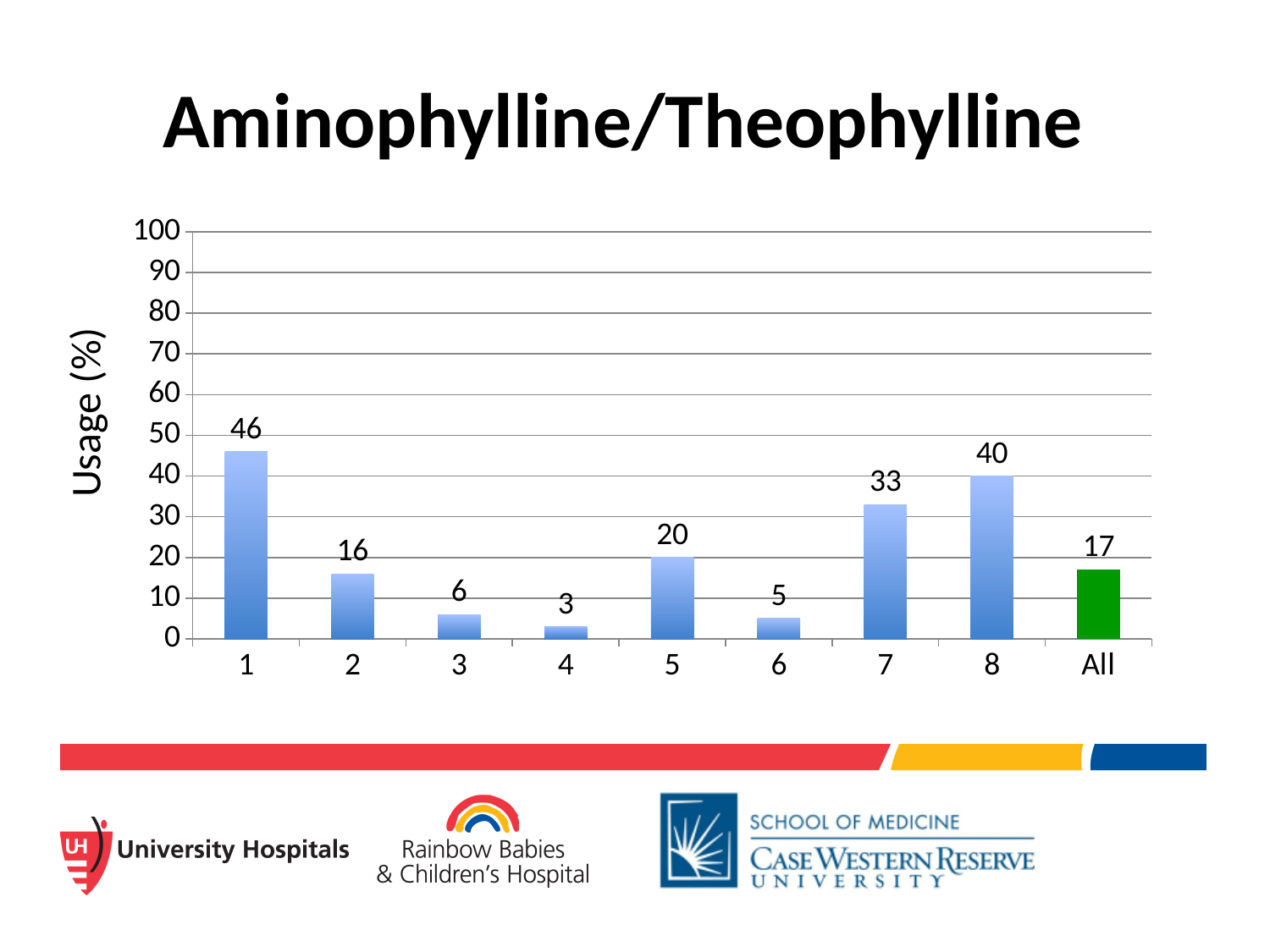
What is the usage (%) for category 7? 33 What is the usage (%) for category 1? 46 Which category has the lowest usage? 4 What is the title of the chart? Aminophylline/Theophylline What is the difference in usage between category 7 and category 2? 17 What is the difference in usage between category 1 and category 8? 6 What kind of chart is shown on the slide? bar chart What is the usage (%) for the 'All' category? 17 Which category has the highest usage? 1 How many categories are shown on the x axis? 9 Which has higher usage, category 5 or category 6? 5 Is the usage for category 8 greater or less than 30? greater